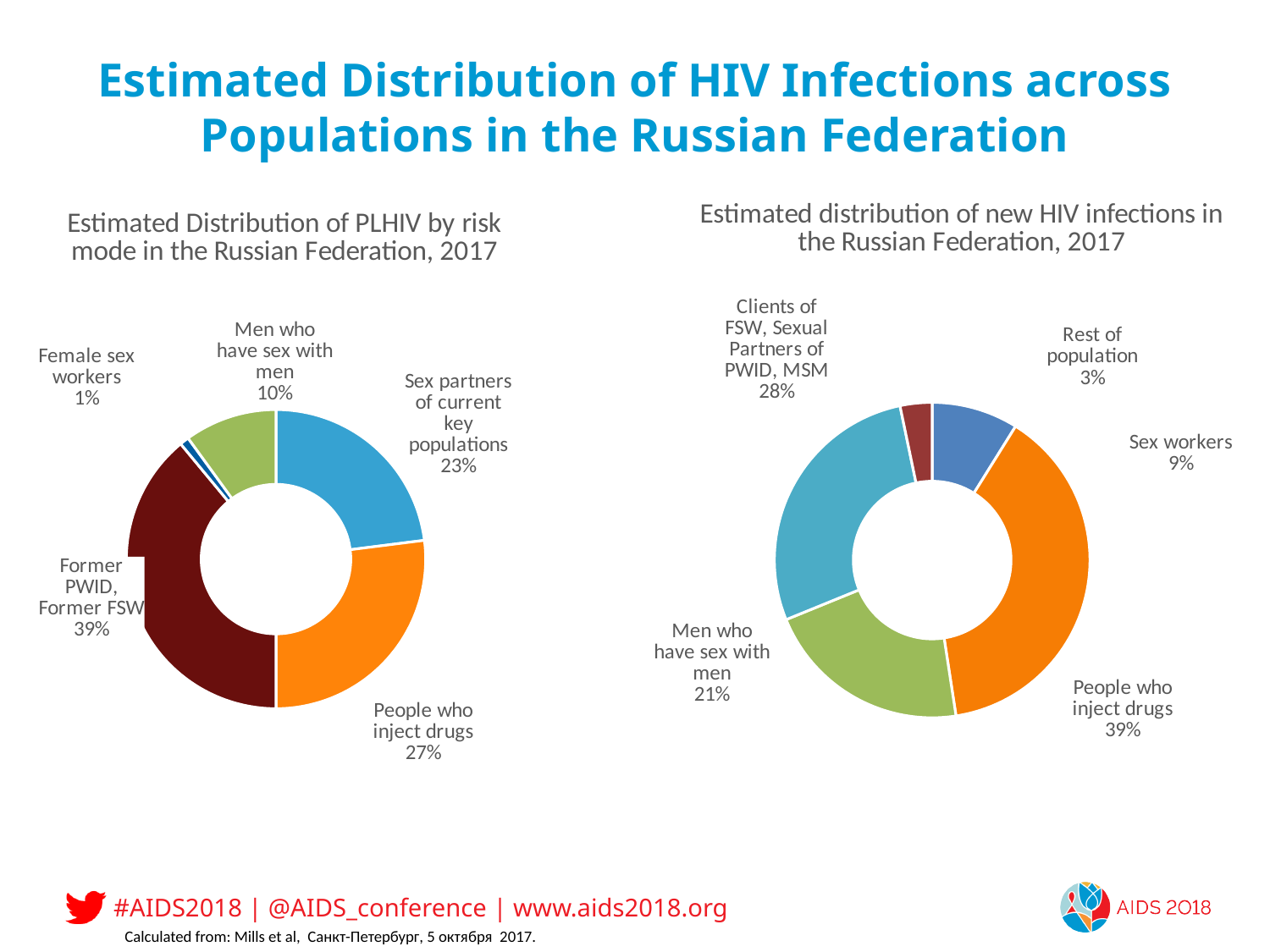
In the left chart (Estimated Distribution of PLHIV by risk mode), what share is shown for Sex partners of current key populations? 23% In the right chart (Estimated distribution of new HIV infections), which is larger: the share for Sex workers or the share for Men who have sex with men? Men who have sex with men In the left chart (Estimated Distribution of PLHIV by risk mode), which category has the smallest share? Female sex workers In the left chart (Estimated Distribution of PLHIV by risk mode in the Russian Federation, 2017), what share is shown for People who inject drugs? 27% In the left chart (Estimated Distribution of PLHIV by risk mode), how many categories are shown? 5 In the left chart (Estimated Distribution of PLHIV by risk mode), which category has the largest share? Former PWID, Former FSW In the right chart (Estimated distribution of new HIV infections), which category has the smallest share? Rest of population In the right chart (Estimated distribution of new HIV infections in the Russian Federation, 2017), what share is shown for Men who have sex with men? 21% In the left chart (Estimated Distribution of PLHIV by risk mode), what is the difference between the shares for Former PWID, Former FSW and Men who have sex with men? 29% In the right chart (Estimated distribution of new HIV infections), what is the difference between the shares for People who inject drugs and Sex workers? 30% What type of chart is used on this slide? Pie chart (doughnut) In the right chart (Estimated distribution of new HIV infections), what share is shown for Clients of FSW, Sexual Partners of PWID, MSM? 28%